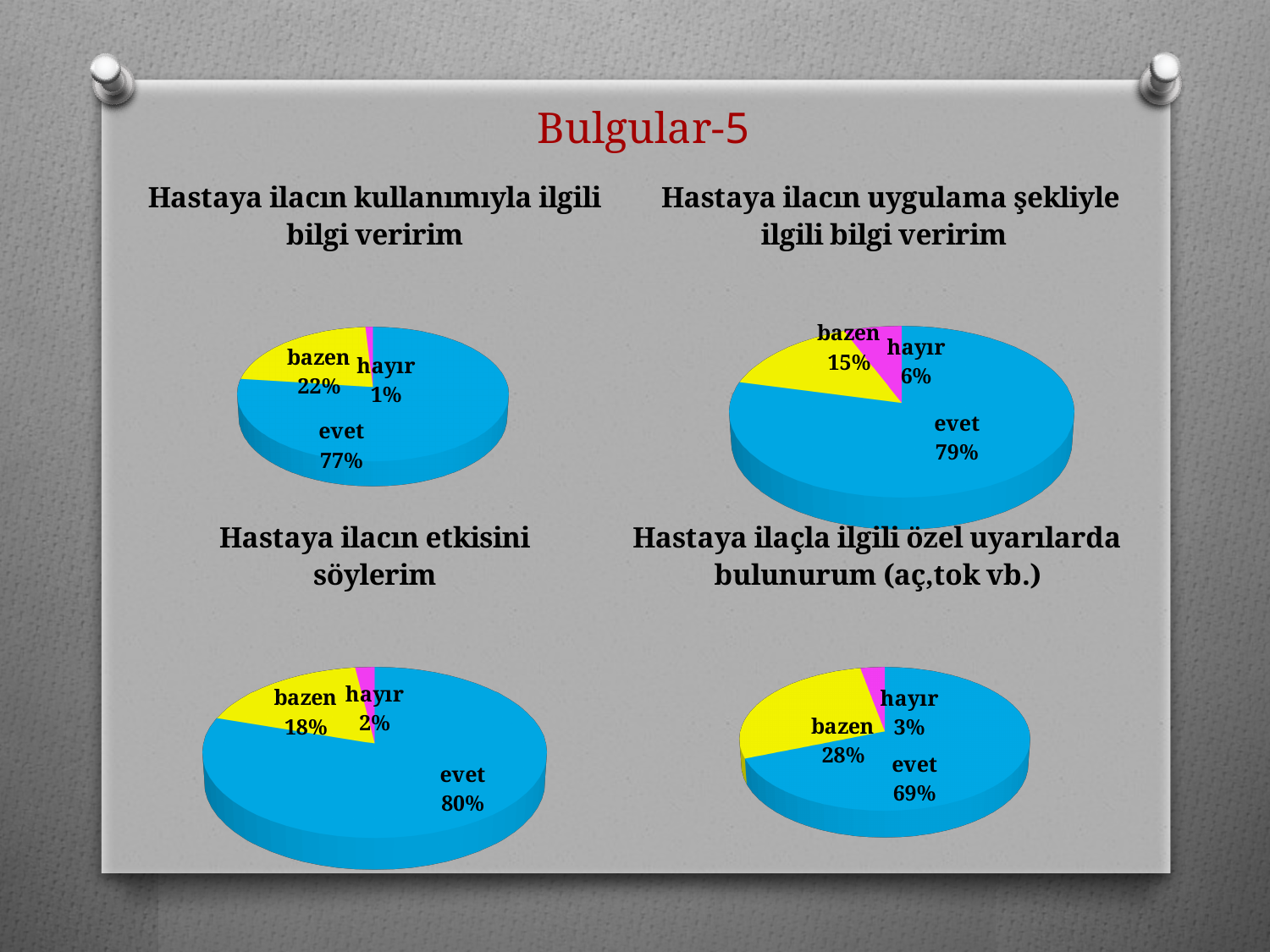
In the top-left pie chart ("Hastaya ilacın kullanımıyla ilgili bilgi veririm"), what is the share for "evet"? 77% In the top-left pie chart ("Hastaya ilacın kullanımıyla ilgili bilgi veririm"), which category has the smallest share? hayır In the bottom-left pie chart ("Hastaya ilacın etkisini söylerim"), what is the share for "hayır"? 2% In the top-right pie chart ("Hastaya ilacın uygulama şekliyle ilgili bilgi veririm"), what is the share for "bazen"? 15% In the bottom-left pie chart ("Hastaya ilacın etkisini söylerim"), which is larger, "bazen" or "hayır"? bazen In the bottom-right pie chart ("Hastaya ilaçla ilgili özel uyarılarda bulunurum"), what is the share for "bazen"? 28% How many slices does the bottom-right pie chart ("Hastaya ilaçla ilgili özel uyarılarda bulunurum") have? 3 In the bottom-left pie chart ("Hastaya ilacın etkisini söylerim"), what colour is the "evet" slice? Blue What kind of chart is used in the top-left chart ("Hastaya ilacın kullanımıyla ilgili bilgi veririm")? Pie chart In the top-right pie chart ("Hastaya ilacın uygulama şekliyle ilgili bilgi veririm"), what is the difference between the "evet" and "bazen" shares? 64% In the bottom-right pie chart ("Hastaya ilaçla ilgili özel uyarılarda bulunurum"), which category has the largest share? evet How many pie charts are shown on the slide? 4